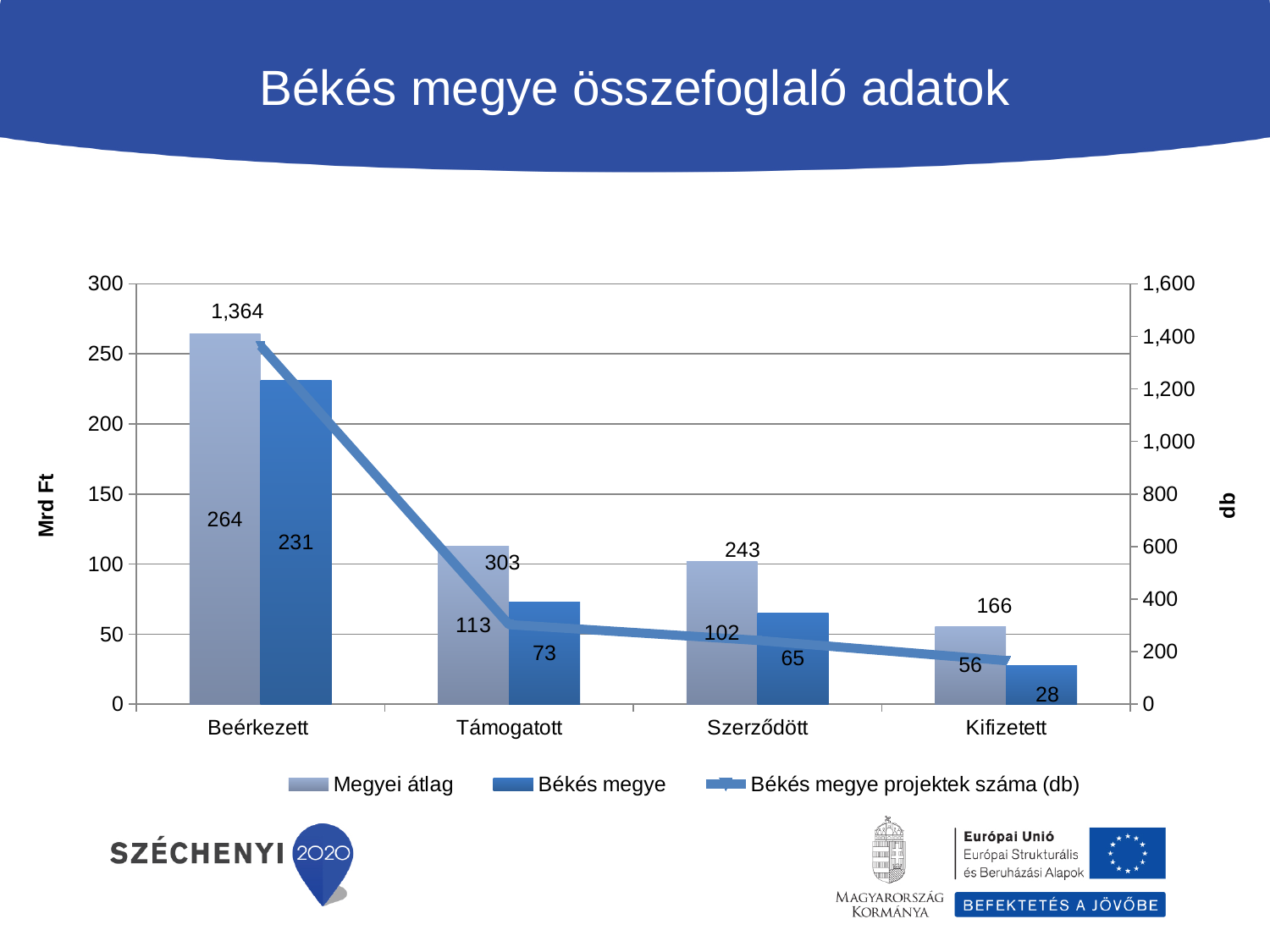
How many categories are shown on the x axis? 4 What is the title of the slide? Békés megye összefoglaló adatok What is the value of Békés megye projektek száma (db) for Támogatott? 303 What is the value of Békés megye for Kifizetett? 28 What is the value of Megyei átlag for Beérkezett? 264 Which category has the highest value for Békés megye projektek száma (db)? Beérkezett How many series does the legend list? 3 What is the label of the left vertical axis? Mrd Ft Which category has the lowest value for Megyei átlag? Kifizetett Does the value of Békés megye projektek száma (db) rise or fall from Beérkezett to Kifizetett? fall What is the difference between Megyei átlag and Békés megye for Szerződött? 37 Which is larger for Támogatott: Megyei átlag or Békés megye? Megyei átlag